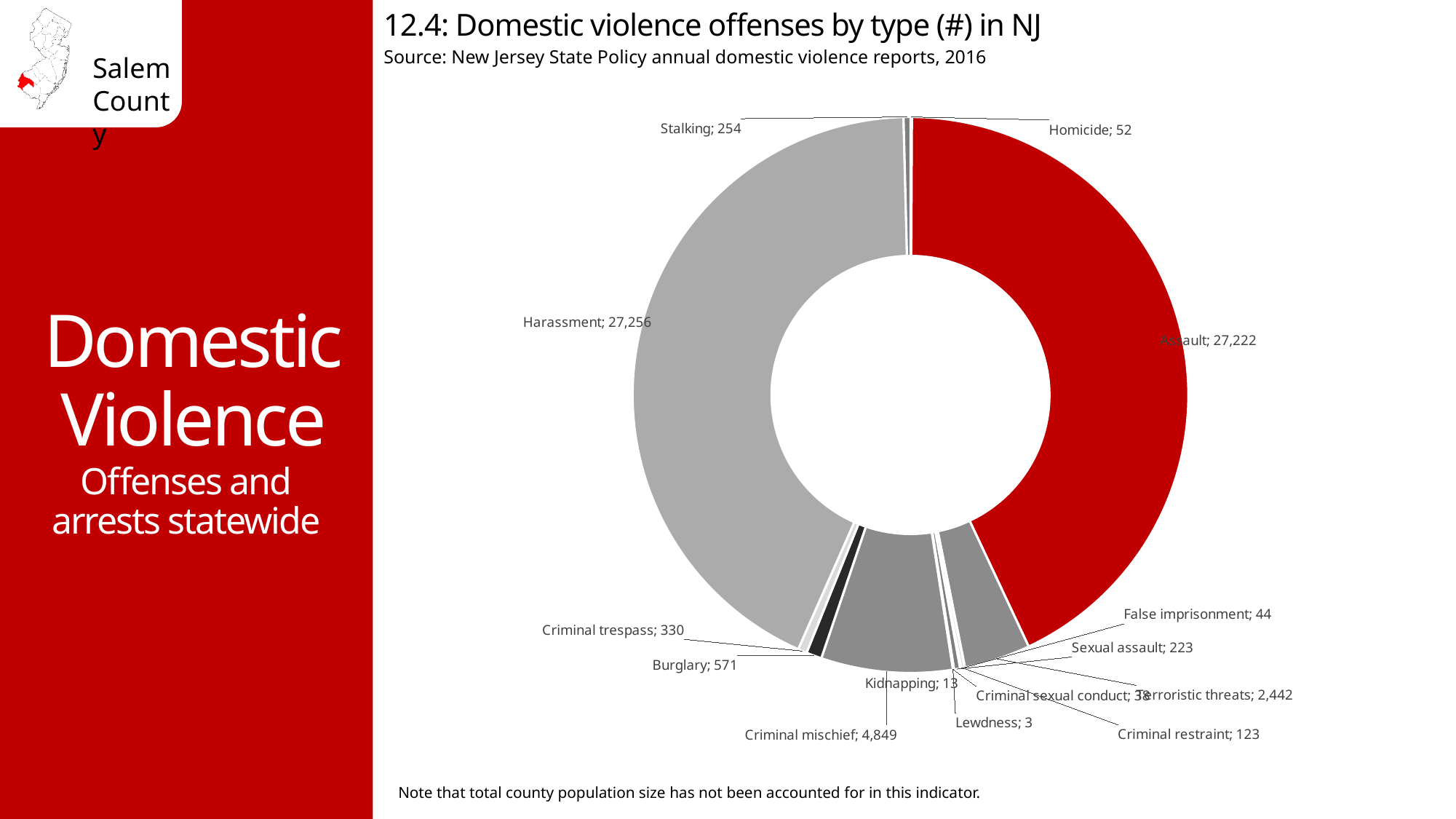
What is the number of Assault offenses? 27,222 What is the number of Harassment offenses? 27,256 What year is cited in the chart's source line? 2016 Which is larger, Burglary or Criminal trespass? Burglary What is the value for Terroristic threats? 2,442 How many offense types are shown in the chart? 14 What is the value for Criminal mischief? 4,849 What type of chart is shown on the slide? doughnut chart Which offense type has the lowest value? Lewdness What is the difference between Criminal mischief and Burglary? 4,278 Which offense type has the highest value? Harassment What is the difference between Harassment and Assault? 34